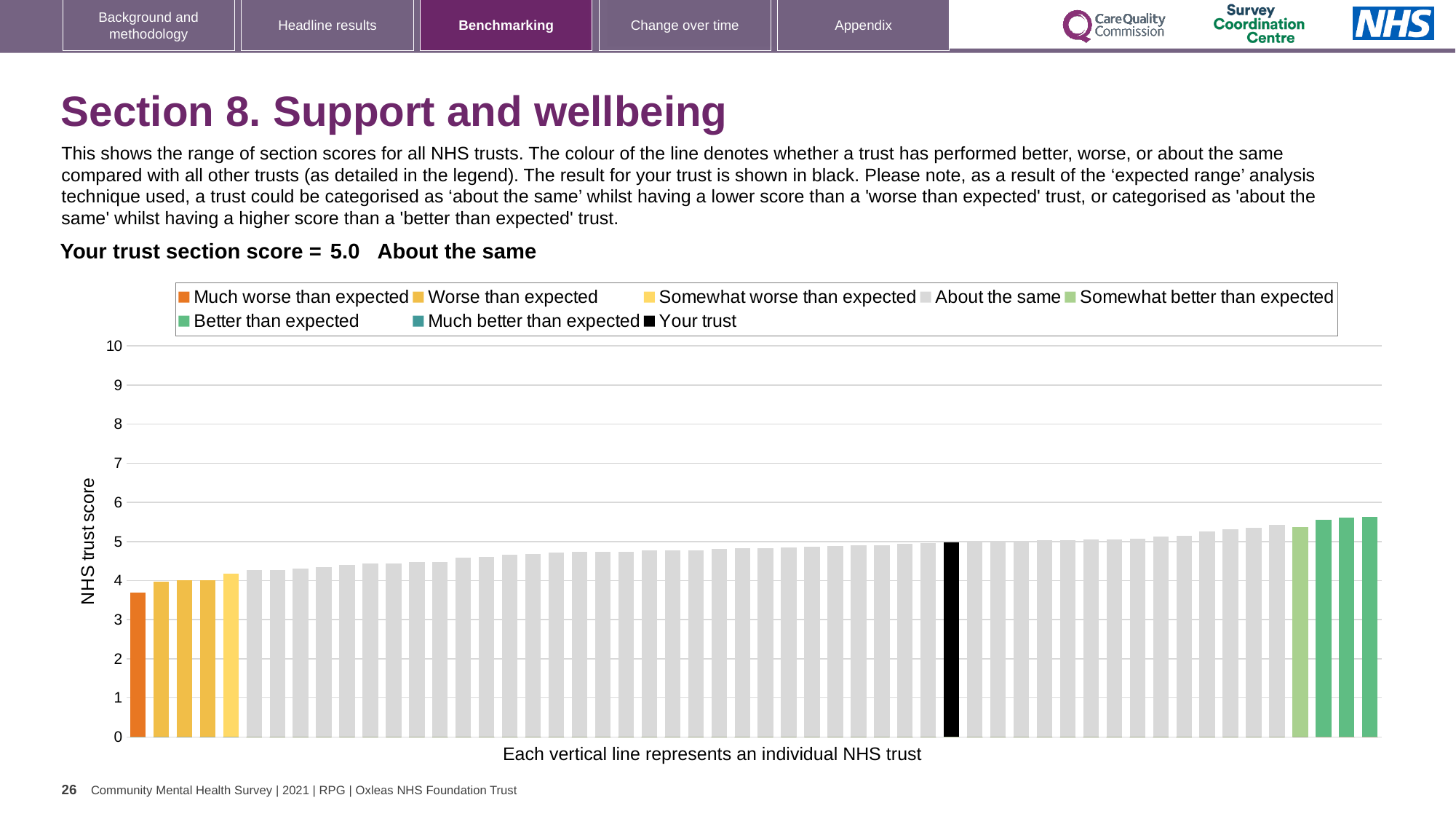
What is the label on the vertical axis of the chart? NHS trust score How many bars are coloured orange, representing 'Much worse than expected'? 1 Is the value of the lowest bar (the orange 'Much worse than expected' trust) greater or less than 4? less How many entries does the chart legend list? 8 Which benchmarking category is your trust placed in for Section 8? About the same Do the bar values rise or fall moving from left to right along the x axis? rise What is the highest value shown on the vertical axis? 10 What colour is used for the 'Your trust' bar according to the legend? black Is the value of the black 'Your trust' bar greater or less than 4? greater Is the value of the highest bar on the chart greater or less than 5? greater What is the section score for your trust shown on the slide? 5.0 What kind of chart is shown on the slide? bar chart